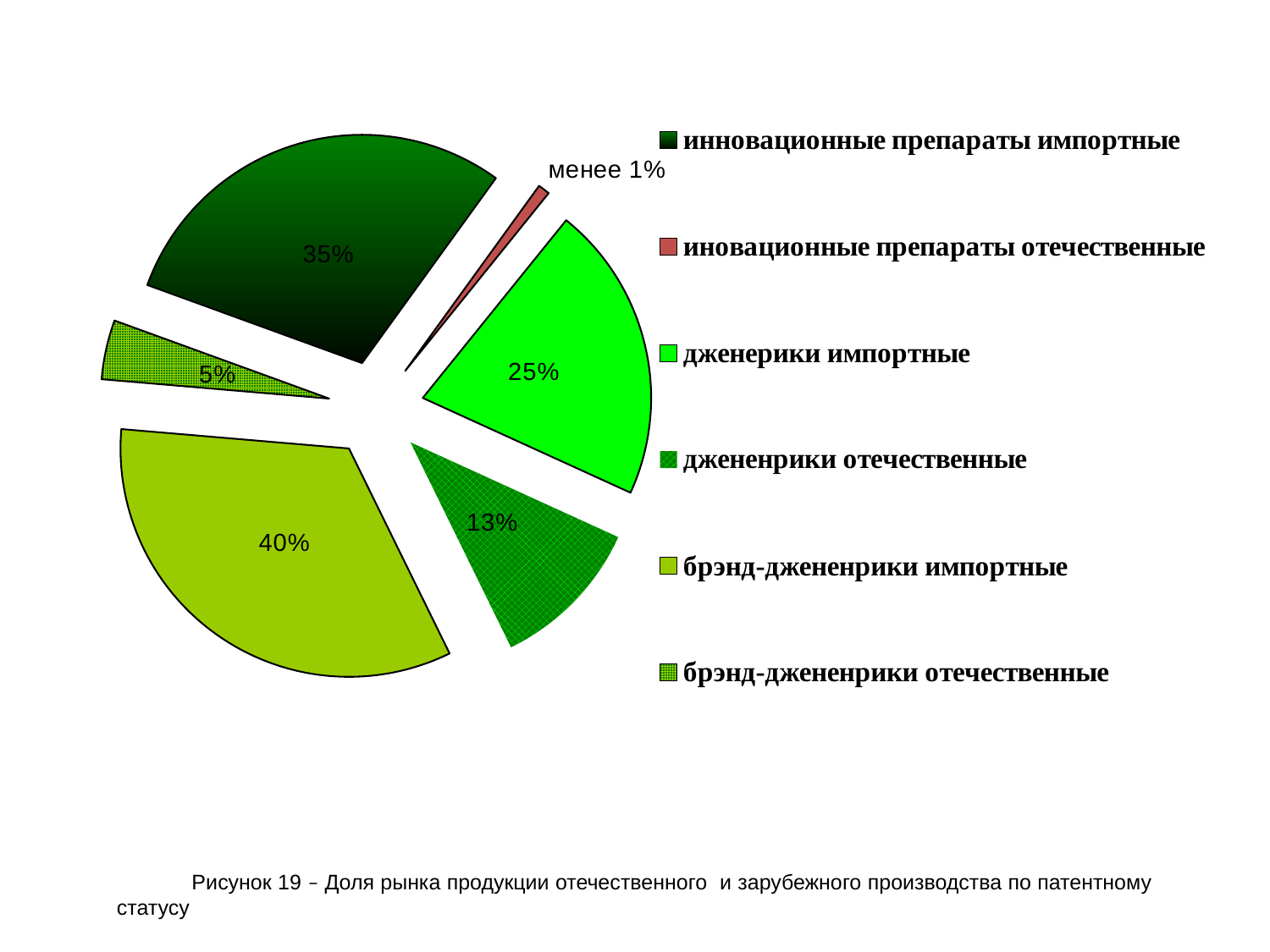
What share is shown for брэнд-джененрики отечественные? 5% What share is shown for брэнд-джененрики импортные? 40% What is the difference between the shares of брэнд-джененрики импортные and дженерики импортные? 15% What share is shown for джененрики отечественные? 13% What label is shown for the иновационные препараты отечественные slice? менее 1% What share is shown for дженерики импортные? 25% How many categories does the legend list? 6 Which is larger, the share of инновационные препараты импортные or the share of джененрики отечественные? инновационные препараты импортные Which category has the largest slice of the pie? брэнд-джененрики импортные What kind of chart is shown on the slide? pie chart Which category has the smallest slice of the pie? иновационные препараты отечественные What share is shown for инновационные препараты импортные? 35%